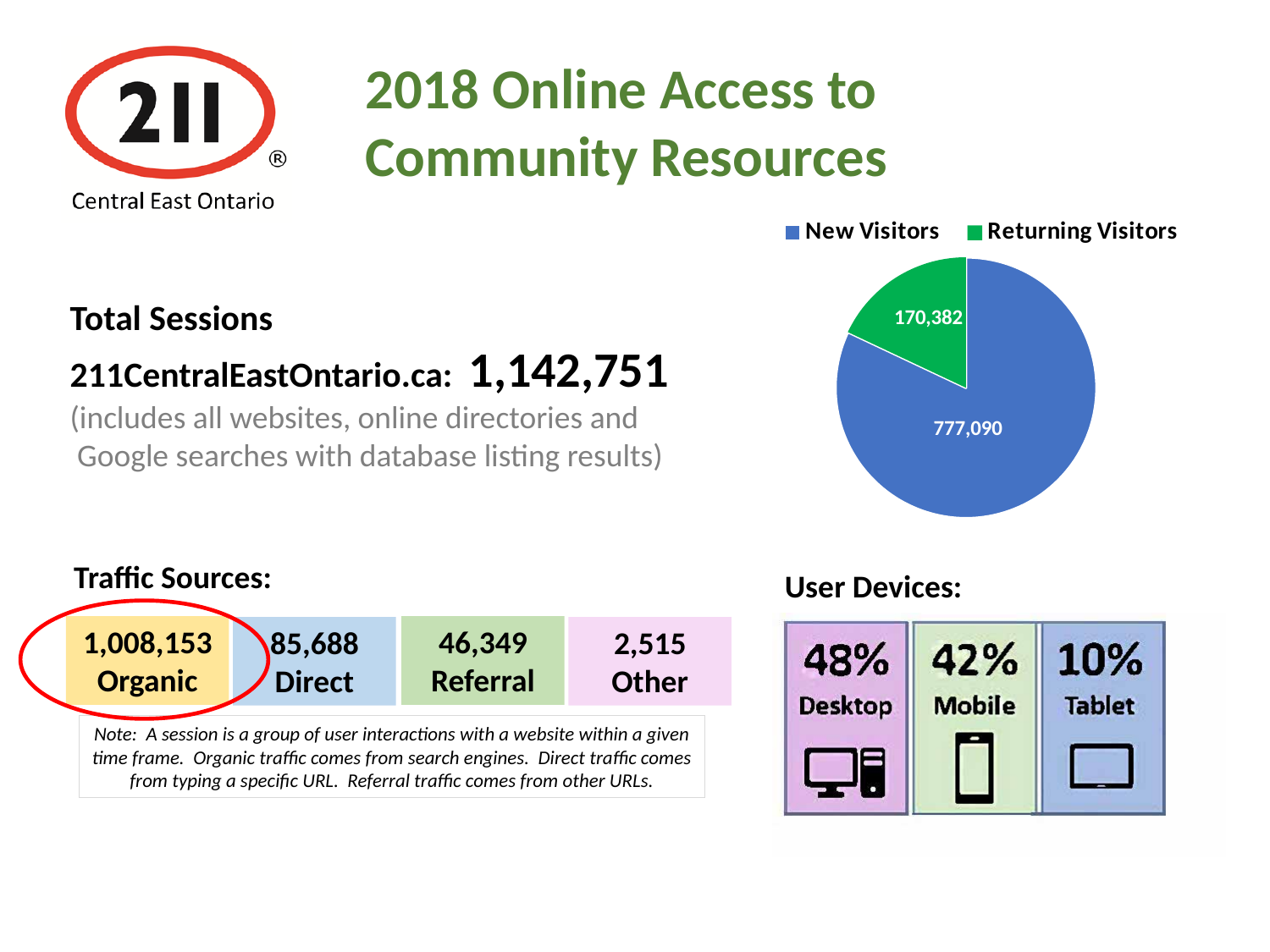
In the pie chart, what is the value for New Visitors? 777,090 Which slice of the pie chart is the largest? New Visitors What is the total of the two slices in the pie chart? 947,472 What type of chart is shown on the slide? pie chart How many slices does the pie chart have? 2 What colour is the Returning Visitors slice in the pie chart? green How many entries does the pie chart legend list? 2 Which slice of the pie chart is the smallest? Returning Visitors In the pie chart, what is the value for Returning Visitors? 170,382 What is the difference between New Visitors and Returning Visitors in the pie chart? 606,708 In the pie chart, which is larger: New Visitors or Returning Visitors? New Visitors